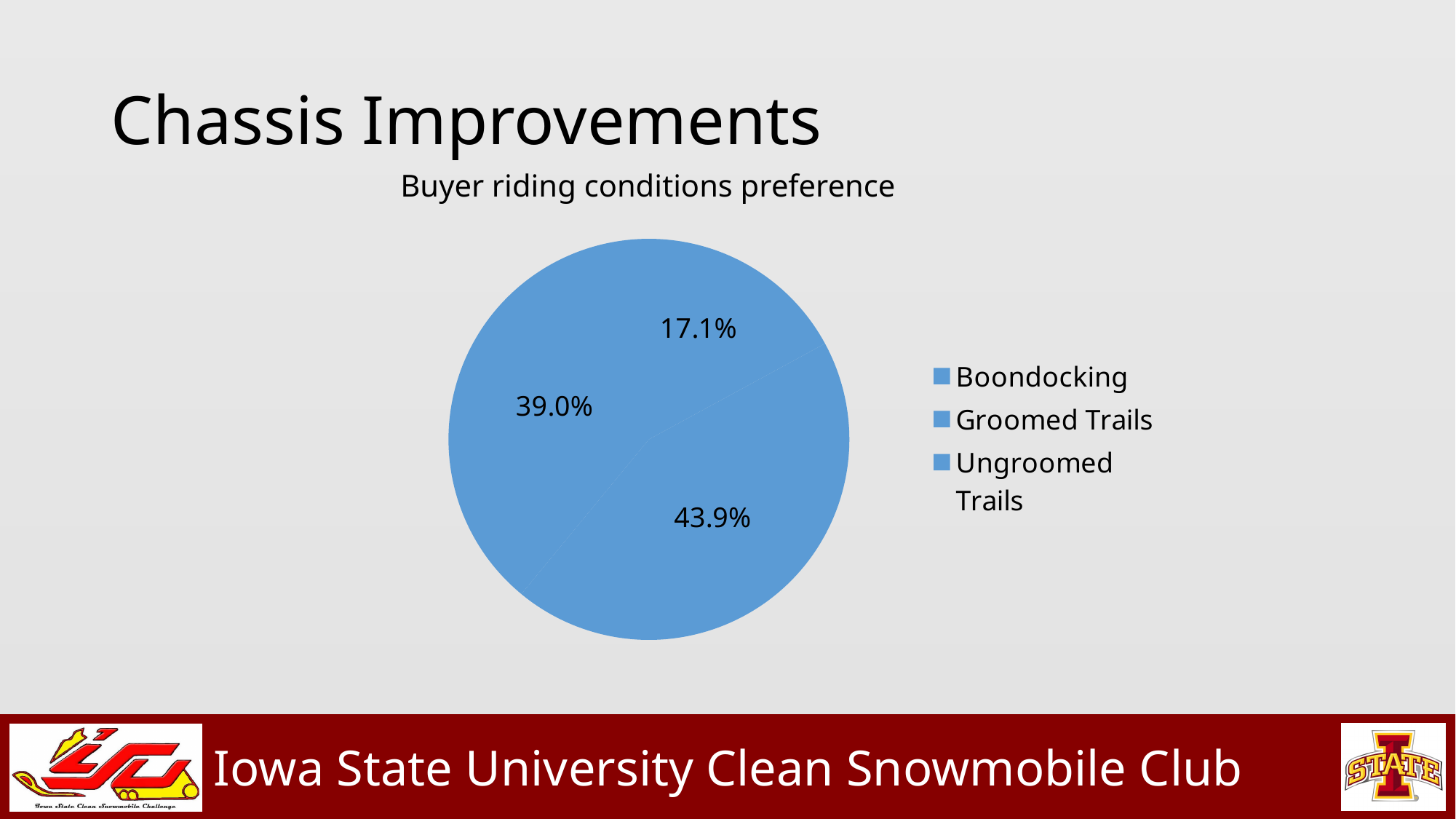
What is the difference between the largest and smallest slice percentages? 26.8% What is the title of the chart? Buyer riding conditions preference Is the largest slice of the pie greater or less than 50%? less How many entries does the chart legend list? 3 Which is larger, the 39.0% slice or the 17.1% slice? the 39.0% slice What is the smallest percentage shown on the pie chart? 17.1% What is the largest percentage shown on the pie chart? 43.9% What kind of chart is shown on the slide? pie chart How many slices does the pie chart have? 3 What is the difference between the 43.9% slice and the 39.0% slice? 4.9% What do the three slice percentages add up to? 100% Which legend entries are listed in the chart? Boondocking, Groomed Trails, Ungroomed Trails